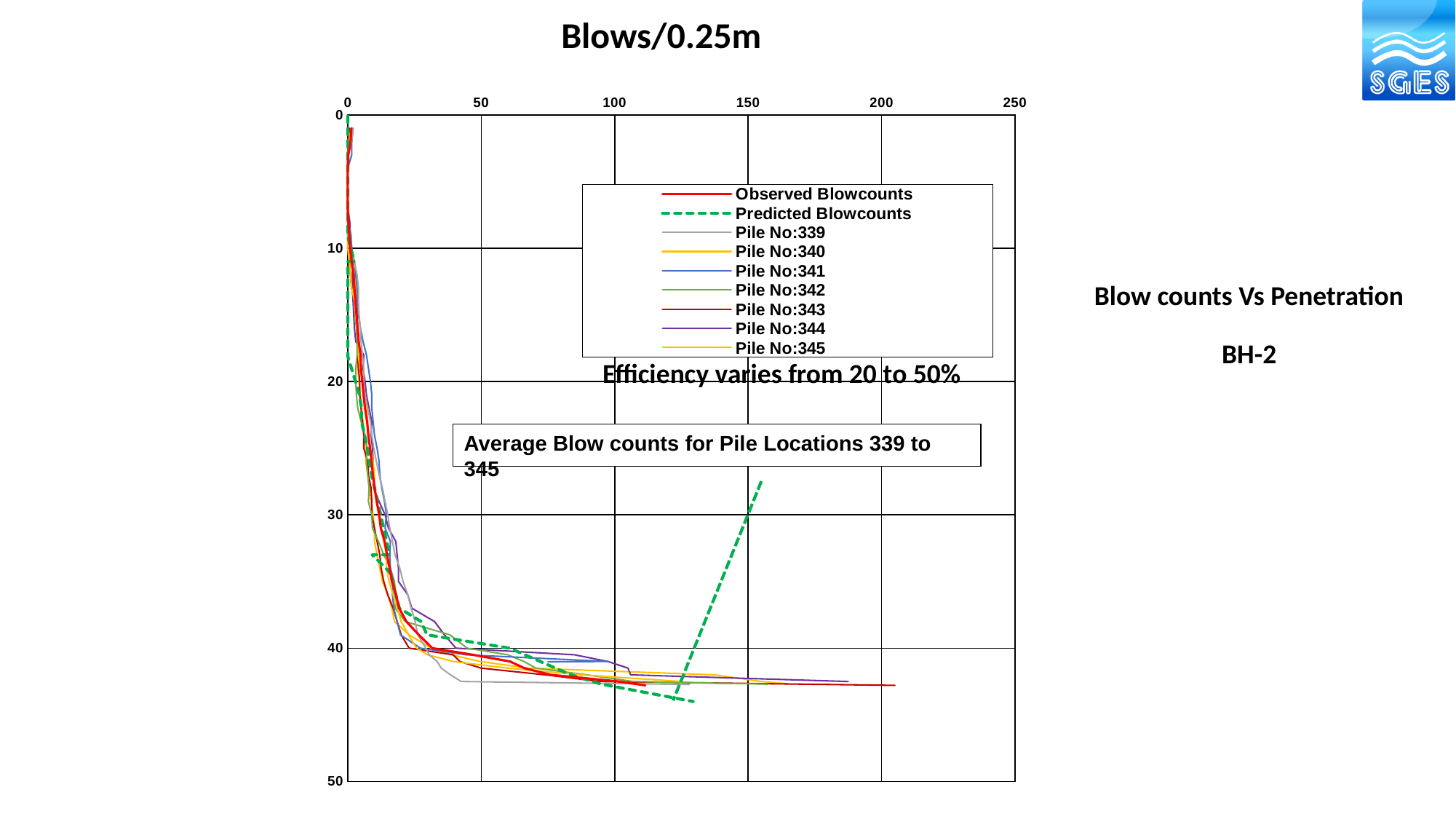
What kind of chart is shown on the slide? Line chart What is the highest value shown on the horizontal (blows) axis? 250 Which series reaches a higher maximum blow count, Observed Blowcounts or Predicted Blowcounts? Predicted Blowcounts Which series reaches a higher maximum blow count, Pile No:344 or Pile No:339? Pile No:344 Is the maximum blow count reached by the Predicted Blowcounts series greater or less than 100? greater How many series does the chart's legend list? 9 What is the title shown above the chart? Blows/0.25m As penetration depth increases down the vertical axis, do the blow counts generally increase or decrease? increase What is the largest value shown on the vertical (penetration) axis? 50 Which series in the legend is drawn as a dashed line? Predicted Blowcounts Is the maximum blow count reached by the Observed Blowcounts series greater or less than 150? less Is the maximum blow count reached by Pile No:339 greater or less than 150? less